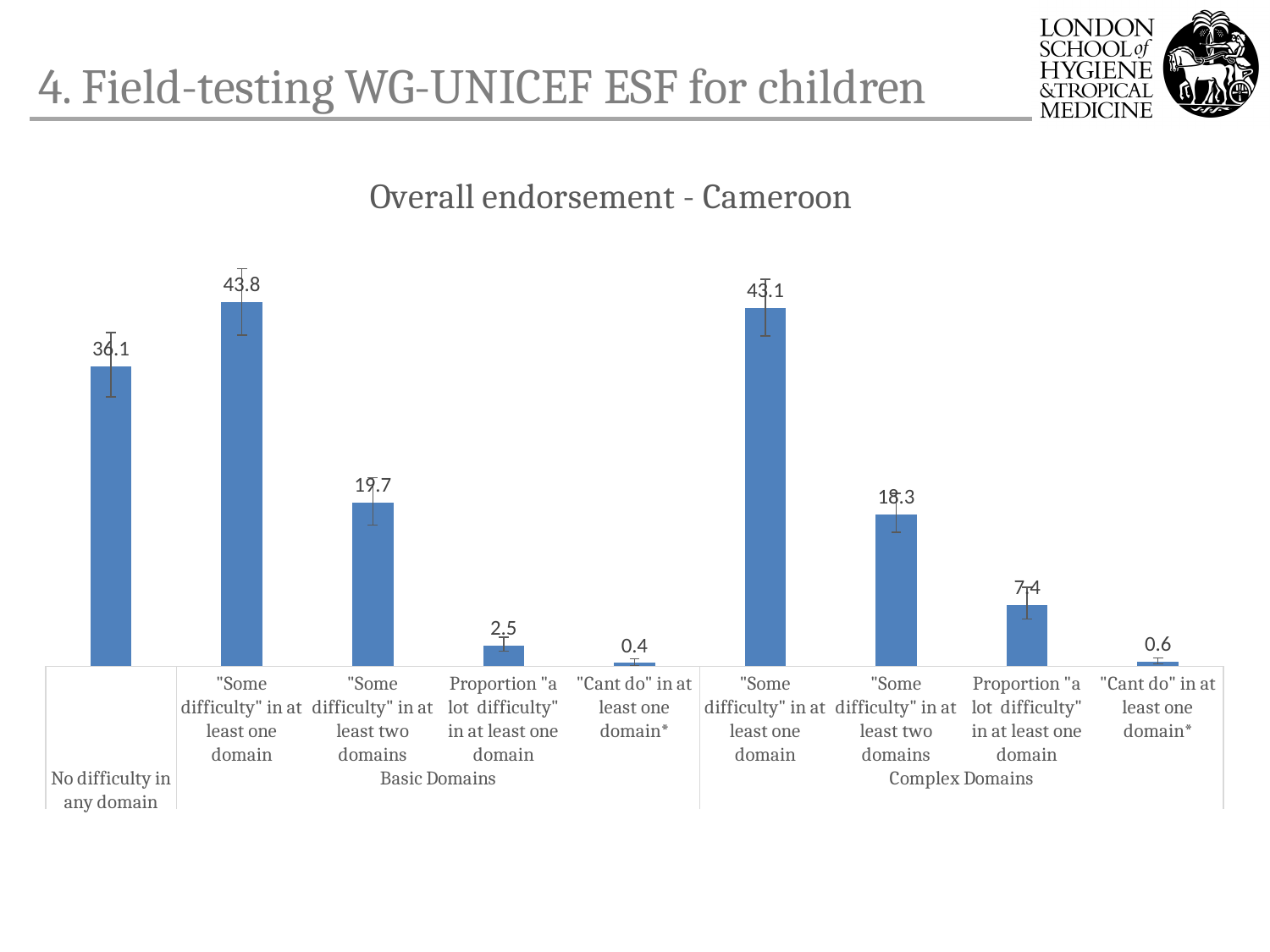
What is the value for "Some difficulty" in at least one domain under Basic Domains? 43.8 What is the value for "Some difficulty" in at least two domains under Complex Domains? 18.3 Which category has the highest value in the chart? "Some difficulty" in at least one domain (Basic Domains) Which category has the lowest value in the chart? "Cant do" in at least one domain* (Basic Domains) What is the difference between "Some difficulty" in at least two domains under Basic Domains and under Complex Domains? 1.4 What is the value for Proportion "a lot difficulty" in at least one domain under Complex Domains? 7.4 What is the value for "Cant do" in at least one domain* under Basic Domains? 0.4 What is the title of the chart? Overall endorsement - Cameroon What type of chart is shown on the slide? Bar chart What is the value for "No difficulty in any domain"? 36.1 How many bars are plotted in the chart? 9 Which is larger: Proportion "a lot difficulty" in at least one domain under Basic Domains or under Complex Domains? Complex Domains